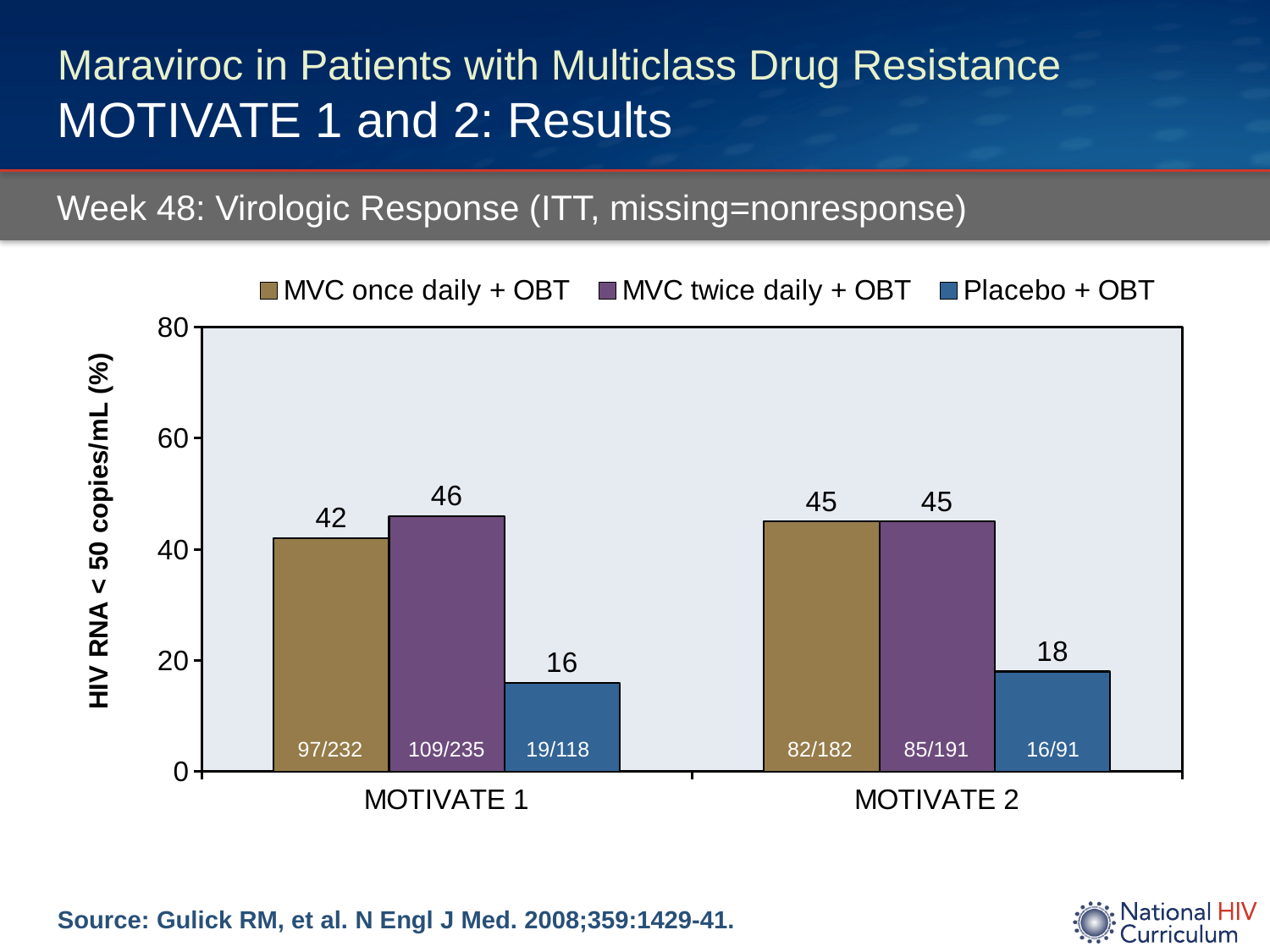
What is the label on the y axis? HIV RNA < 50 copies/mL (%) What kind of chart is shown on the slide? Bar chart What is the difference between MVC once daily + OBT in MOTIVATE 2 and MOTIVATE 1? 3 Which is larger: Placebo + OBT in MOTIVATE 1 or Placebo + OBT in MOTIVATE 2? MOTIVATE 2 How many series does the legend list? 3 What is the value for Placebo + OBT in MOTIVATE 2? 18 Which series has the highest value in MOTIVATE 1? MVC twice daily + OBT What is the value for MVC twice daily + OBT in MOTIVATE 1? 46 What is the difference between MVC twice daily + OBT and Placebo + OBT in MOTIVATE 1? 30 Which series has the lowest value in MOTIVATE 2? Placebo + OBT What is the value for MVC once daily + OBT in MOTIVATE 1? 42 Is the value for MVC once daily + OBT in MOTIVATE 1 greater or less than 40? greater